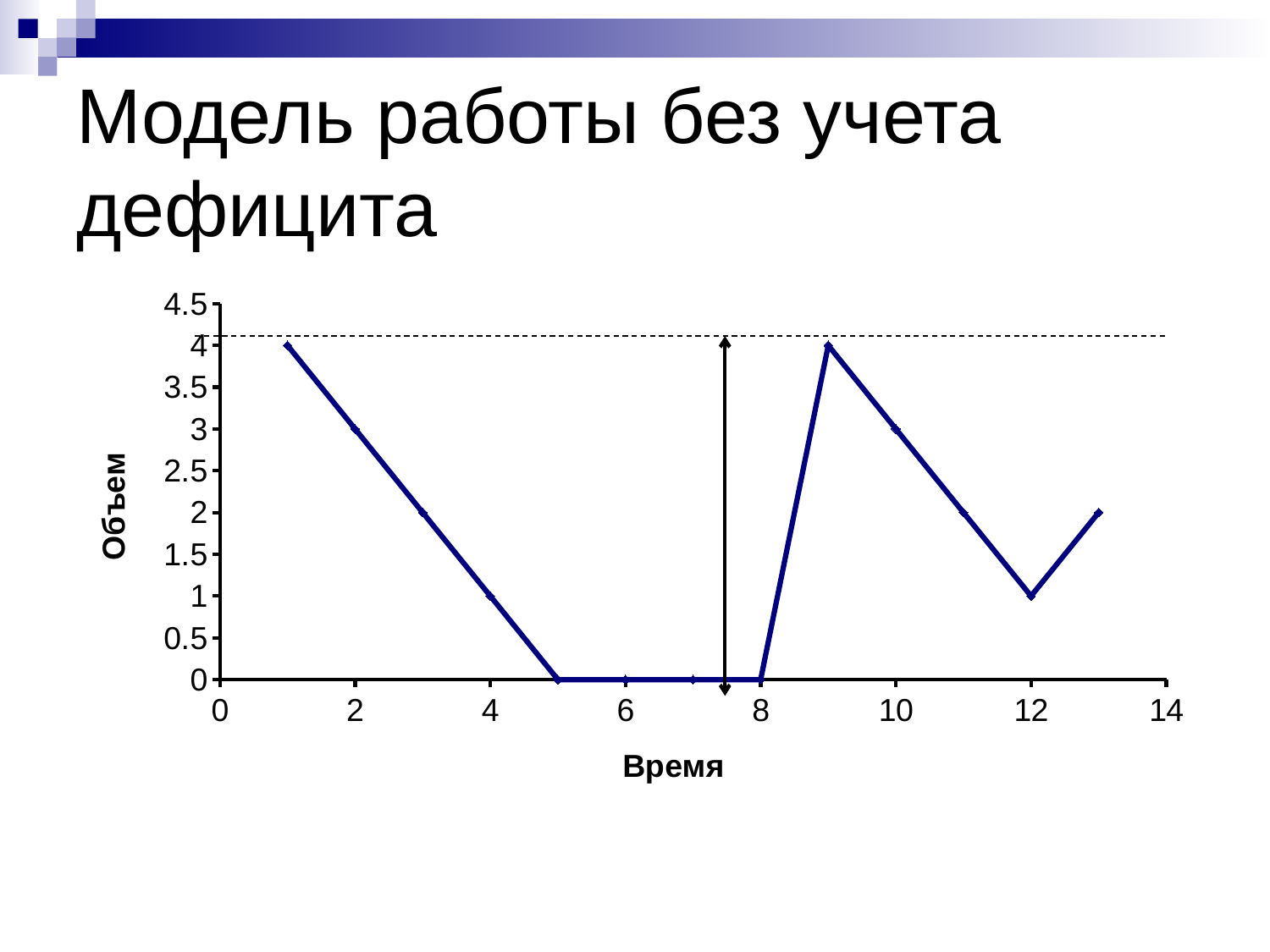
What is the difference between the value of Объем at Время = 9 and at Время = 12? 3 What is the value of Объем at Время = 12? 1 What is the label of the y axis? Объем What is the value of Объем at Время = 9? 4 What kind of chart is shown on the slide? line chart What is the value of Объем at Время = 1? 4 Does the value of Объем rise or fall between Время = 1 and Время = 5? fall How many data points are plotted on the chart? 13 What is the value of Объем at Время = 3? 2 What is the label of the x axis? Время Which is larger, the value of Объем at Время = 2 or at Время = 11? Время = 2 What is the value of Объем at Время = 6? 0